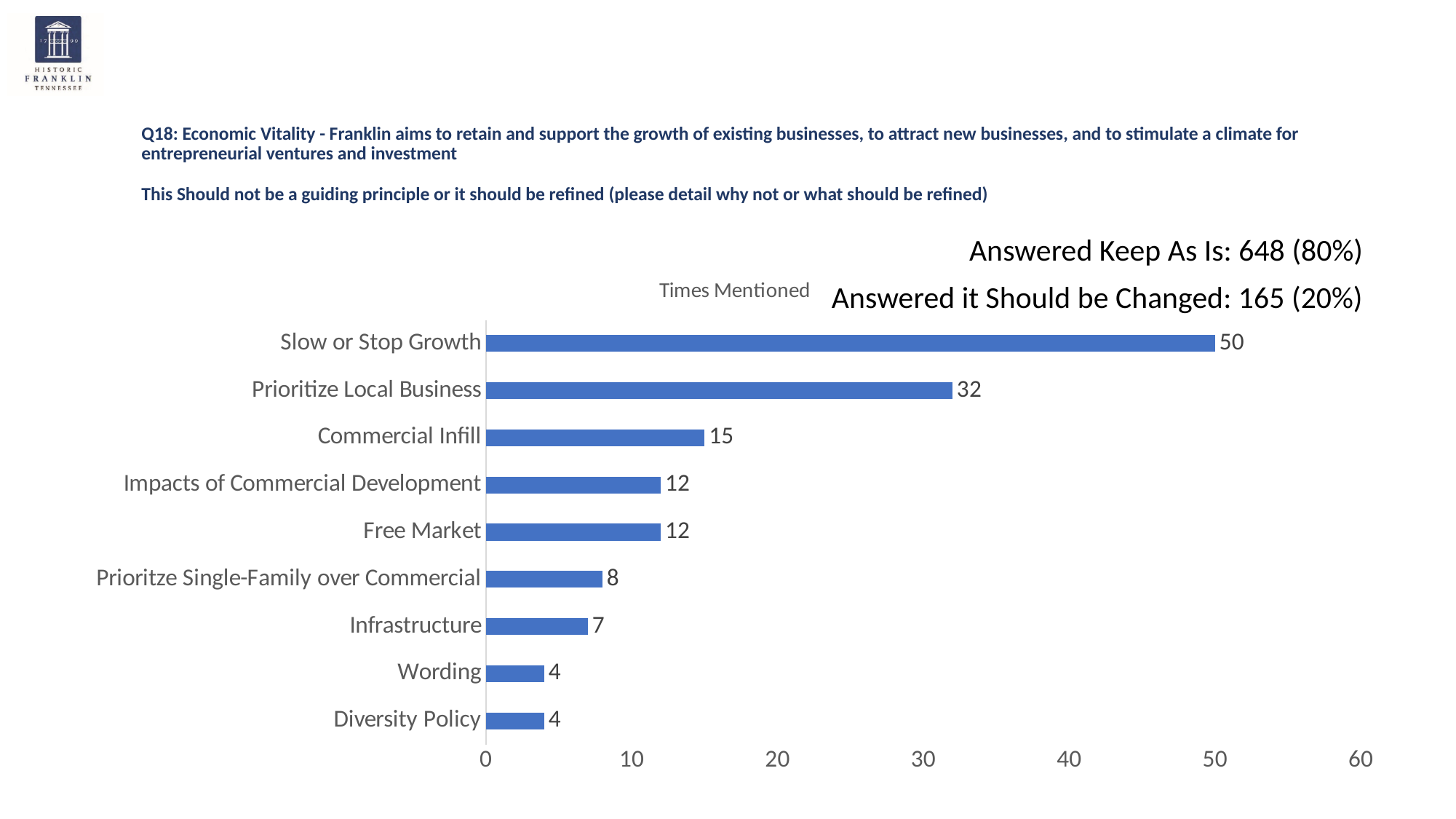
What is the difference between the values for "Slow or Stop Growth" and "Prioritize Local Business"? 18 How many categories are shown in the bar chart? 9 What is the value for "Prioritize Local Business"? 32 What type of chart is shown on the slide? Bar chart What is the title of the chart? Times Mentioned Which is larger, the value for "Prioritize Local Business" or the value for "Commercial Infill"? Prioritize Local Business What is the difference between the values for "Commercial Infill" and "Free Market"? 3 How many times was "Commercial Infill" mentioned? 15 How many times was "Slow or Stop Growth" mentioned? 50 Is the value for "Slow or Stop Growth" greater or less than 40? greater What is the value for "Infrastructure"? 7 Which category has the highest number of times mentioned? Slow or Stop Growth